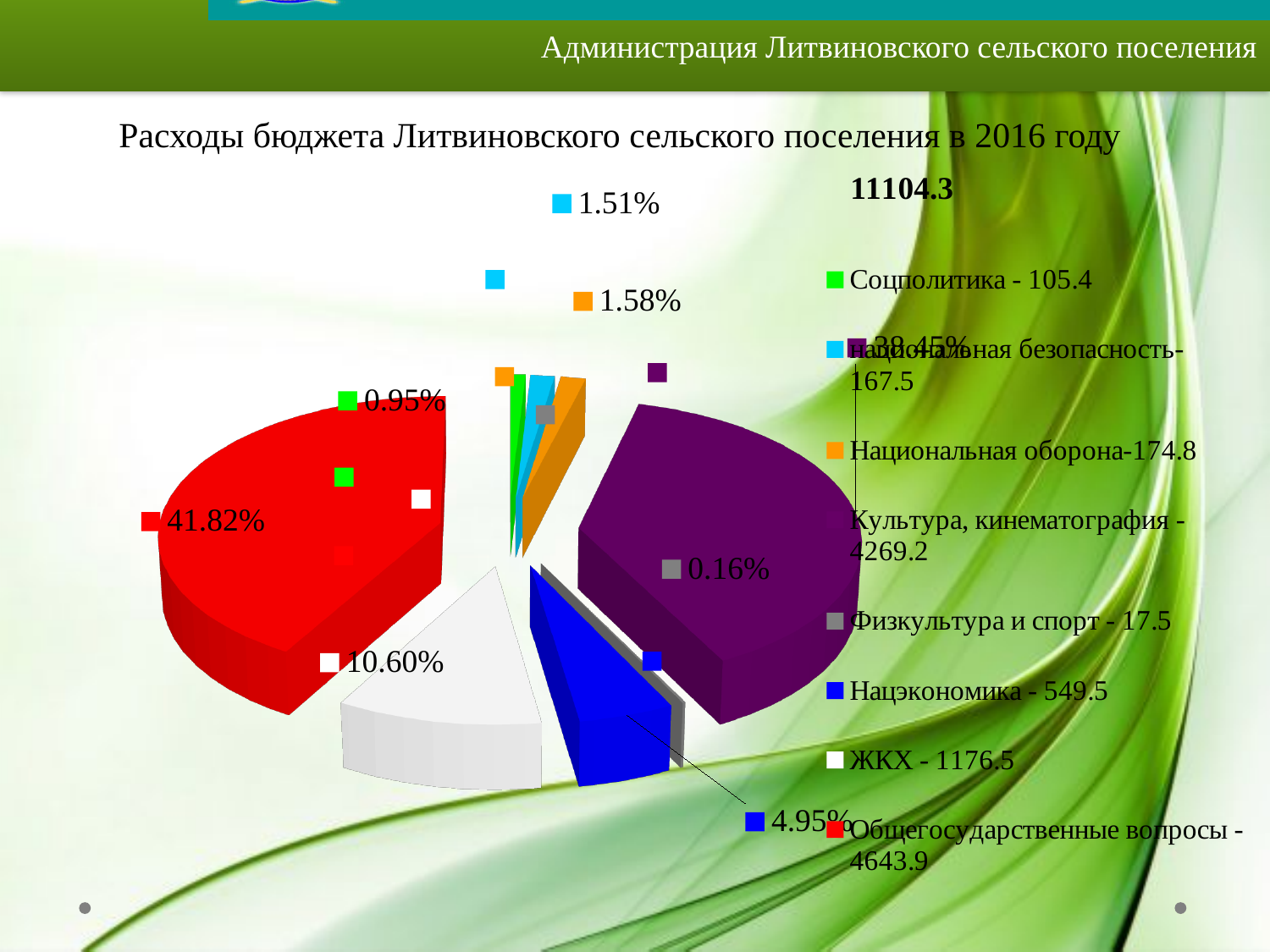
How many categories does the legend of the pie chart list? 8 What percentage share is shown for Физкультура и спорт? 0.16% What is the difference in percentage points between the shares of Общегосударственные вопросы and ЖКХ? 31.22% Which has the larger legend amount: Национальная оборона or Национальная безопасность? Национальная оборона Which category has the largest share of the pie? Общегосударственные вопросы What kind of chart is shown on the slide? pie chart What percentage share is shown for ЖКХ? 10.60% What percentage share is shown for Общегосударственные вопросы? 41.82% What percentage share is shown for Нацэкономика? 4.95% What amount is listed in the legend for Культура, кинематография? 4269.2 Which category has the smallest share of the pie? Физкультура и спорт What is the title of the chart? 11104.3